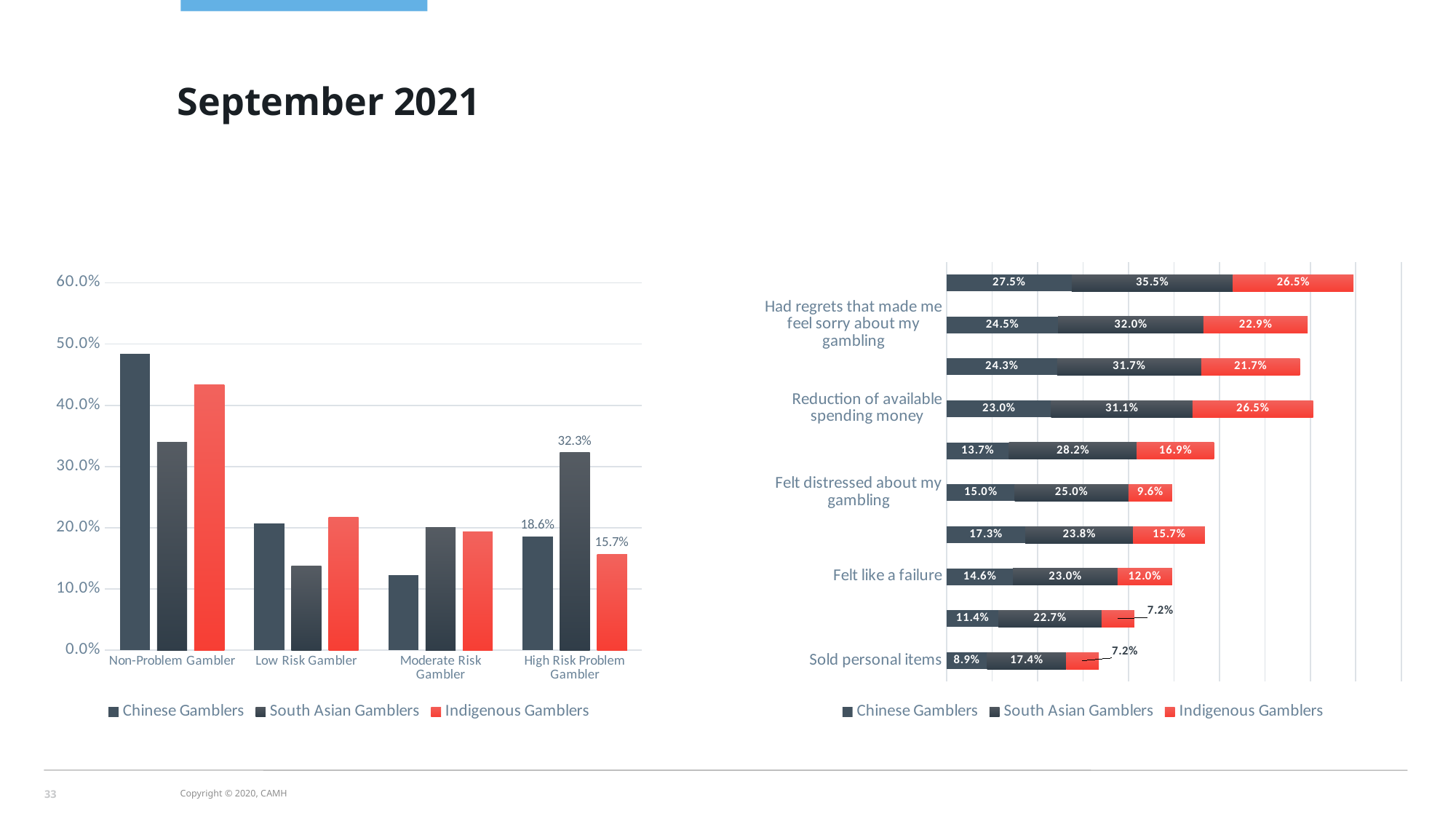
In the left chart, what is the value for Indigenous Gamblers in the High Risk Problem Gambler category? 15.7% In the left chart, what is the difference between the South Asian Gamblers and Chinese Gamblers values for High Risk Problem Gambler? 13.7% In the right chart, for 'Reduction of available spending money', which is larger: the Chinese Gamblers value or the Indigenous Gamblers value? Indigenous Gamblers In the left chart, which category has the highest value for Chinese Gamblers? Non-Problem Gambler In the right chart, what is the value for Indigenous Gamblers for 'Felt like a failure'? 12.0% What kind of chart is the chart on the left of the slide? bar chart In the right chart, what is the value for South Asian Gamblers for 'Sold personal items'? 17.4% How many gambler categories are shown on the x axis of the left chart? 4 In the right chart, what is the total of the stacked bar for 'Sold personal items'? 33.5% In the left chart, what is the value for South Asian Gamblers in the High Risk Problem Gambler category? 32.3% In the left chart, is the value for Chinese Gamblers in the Non-Problem Gambler category greater or less than 40.0%? greater How many series does the legend of the left chart list? 3